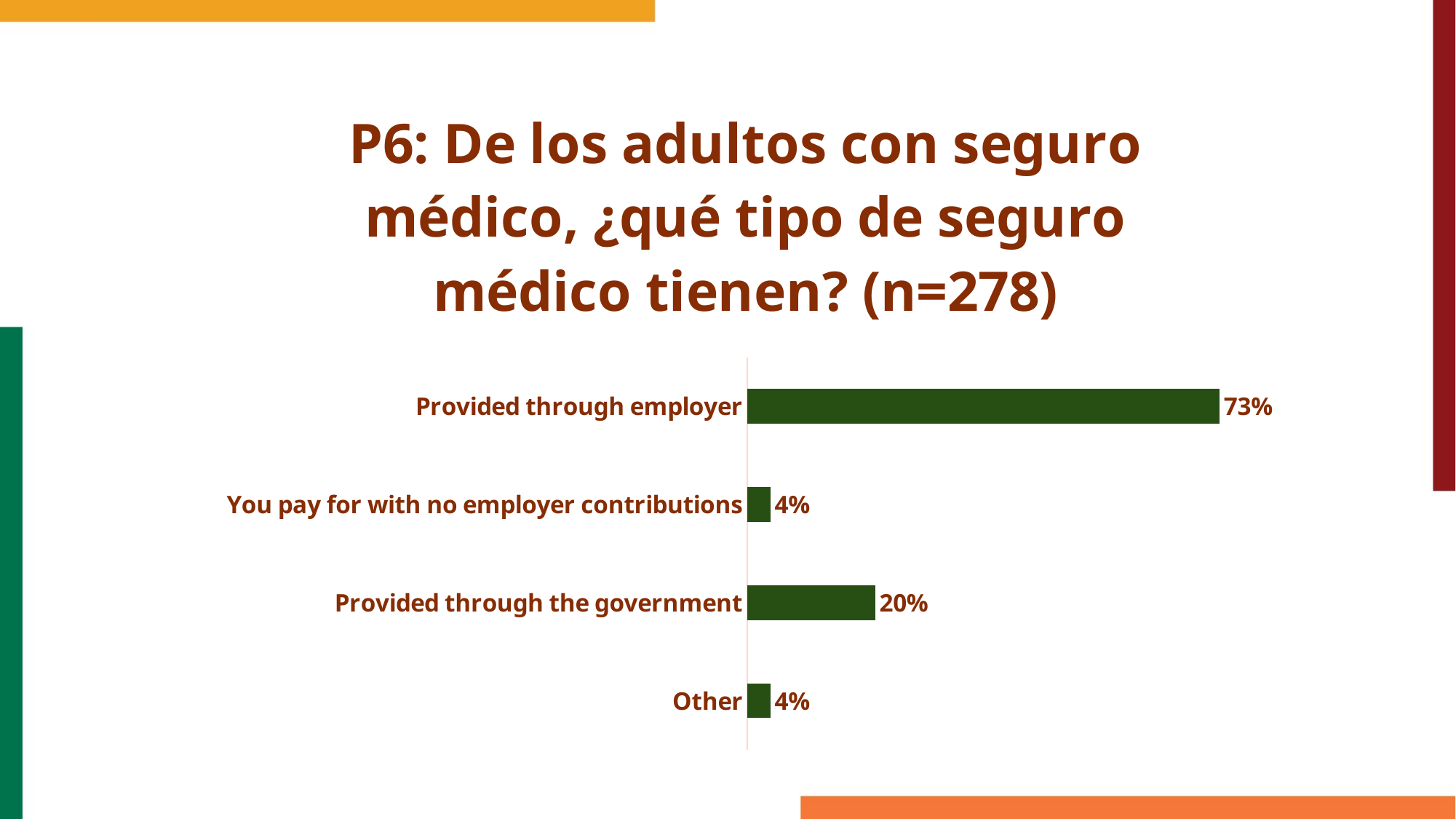
What kind of chart is shown on the slide? Bar chart What is the sample size (n) stated in the slide title? 278 What is the value for the 'Other' category? 4% What is the difference between 'Provided through the government' and 'Other'? 16% How many categories are shown in the chart? 4 Which category has the highest value? Provided through employer Which is larger: 'Provided through the government' or 'You pay for with no employer contributions'? Provided through the government What percentage of insured adults have insurance provided through their employer? 73% What is the value for 'You pay for with no employer contributions'? 4% What colour are the bars in the chart? Dark green What is the difference between 'Provided through employer' and 'Provided through the government'? 53% What is the value for 'Provided through the government'? 20%